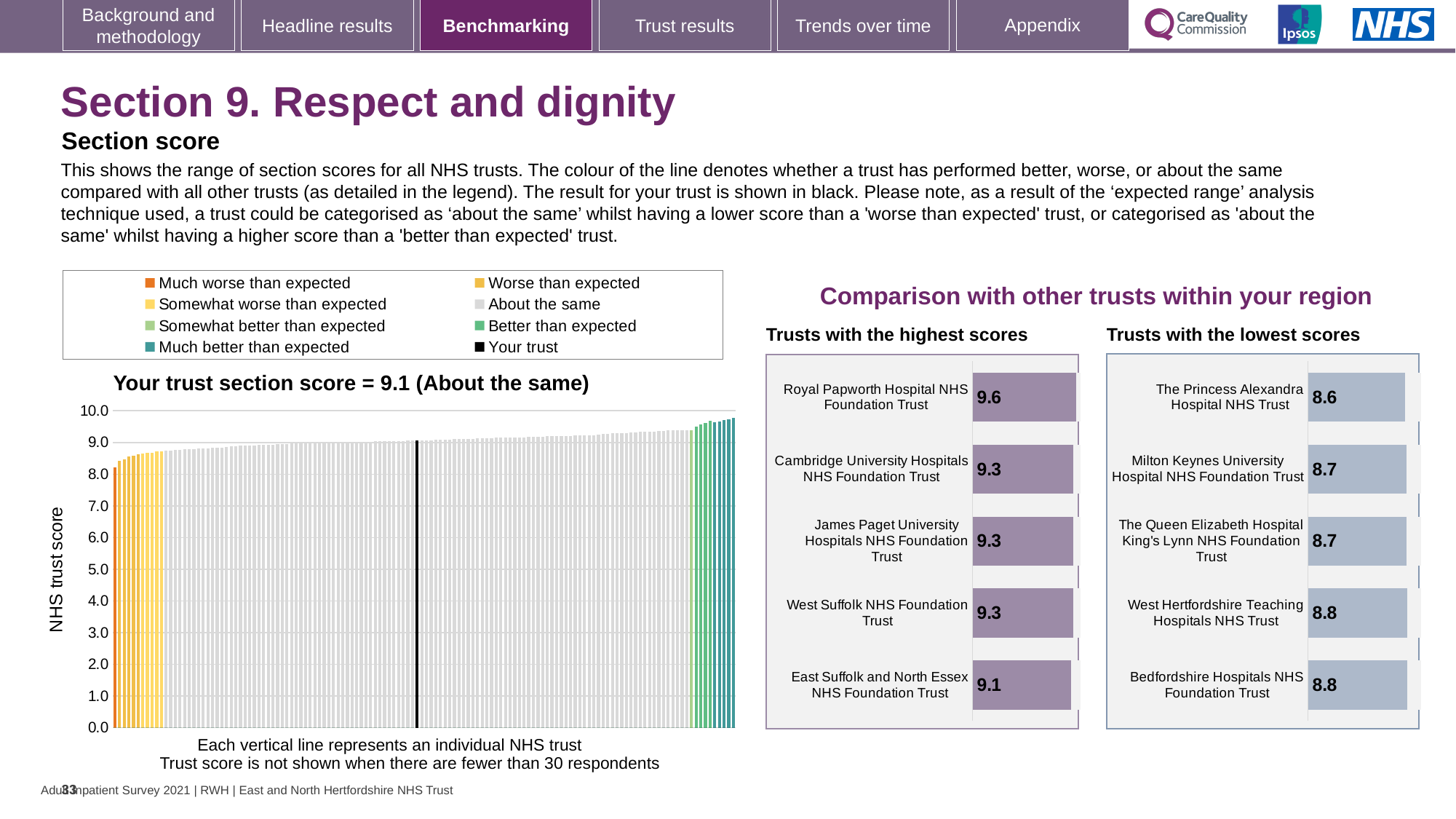
In the 'Your trust section score' chart, do the trust scores rise or fall from left to right along the x axis? rise What kind of chart is the 'Your trust section score' chart? bar chart In the 'Your trust section score' chart, what is the section score for your trust? 9.1 In the 'Trusts with the lowest scores' chart, which trust has the lowest score? The Princess Alexandra Hospital NHS Trust In the 'Your trust section score' chart, is the value of the leftmost (lowest) bar greater or less than 9.0? less How many entries does the legend above the 'Your trust section score' chart list? 8 Which has the larger score: Royal Papworth Hospital NHS Foundation Trust in the 'Trusts with the highest scores' chart or The Princess Alexandra Hospital NHS Trust in the 'Trusts with the lowest scores' chart? Royal Papworth Hospital NHS Foundation Trust In the 'Trusts with the highest scores' chart, how many trusts are shown? 5 In the 'Trusts with the highest scores' chart, what is the difference between the scores of Royal Papworth Hospital NHS Foundation Trust and East Suffolk and North Essex NHS Foundation Trust? 0.5 In the 'Trusts with the highest scores' chart, which trust has the highest score? Royal Papworth Hospital NHS Foundation Trust In the 'Trusts with the lowest scores' chart, what is the score for Milton Keynes University Hospital NHS Foundation Trust? 8.7 In the 'Trusts with the highest scores' chart, what is the score for Royal Papworth Hospital NHS Foundation Trust? 9.6